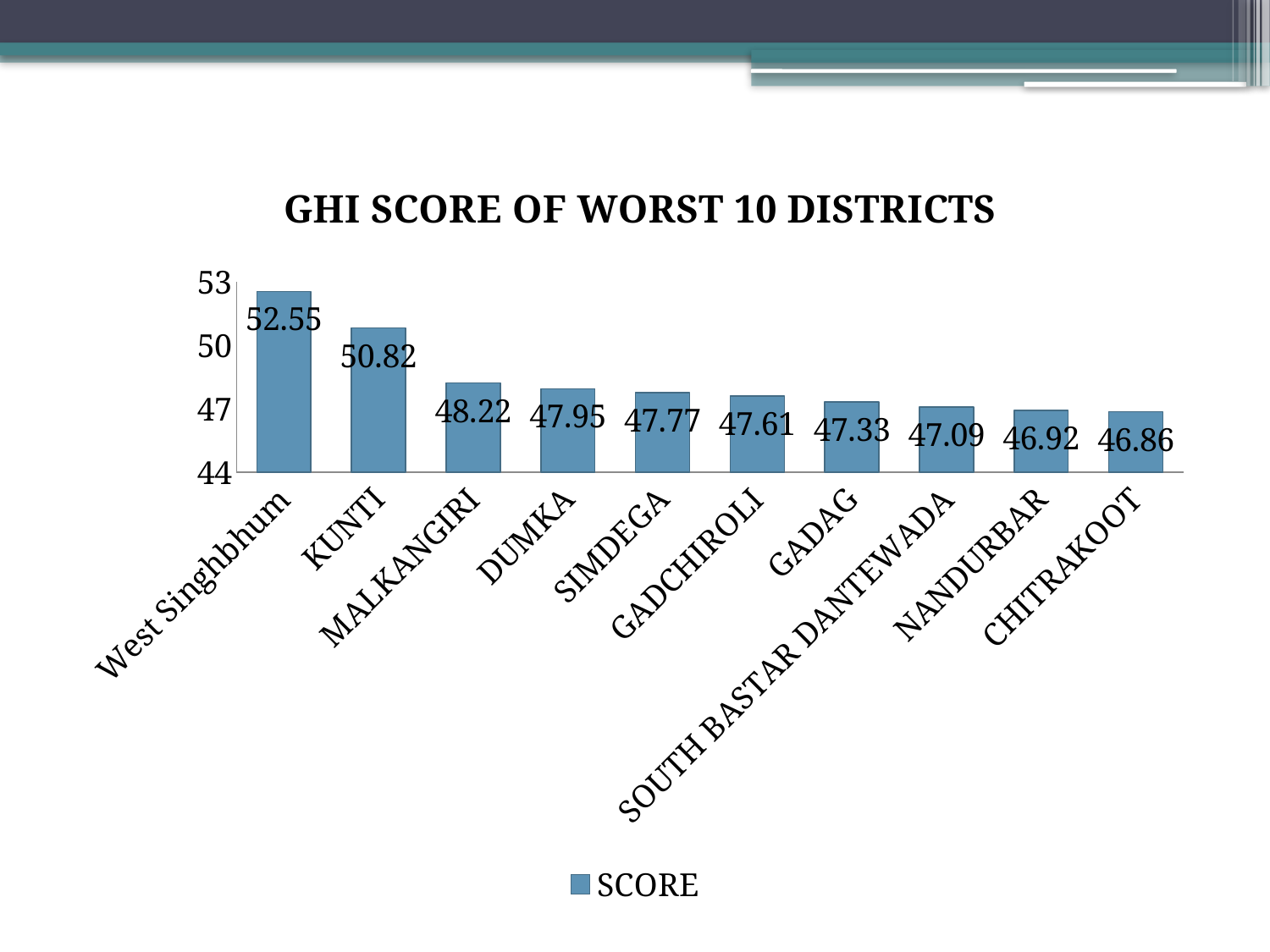
Which has a higher GHI score, MALKANGIRI or GADAG? MALKANGIRI Which district has the lowest GHI score? CHITRAKOOT What is the GHI score for CHITRAKOOT? 46.86 What kind of chart is shown on the slide? Bar chart Which district has the highest GHI score? West Singhbhum What is the GHI score for West Singhbhum? 52.55 What is the difference between the GHI scores of West Singhbhum and KUNTI? 1.73 How many districts are shown in the chart? 10 What is the GHI score for KUNTI? 50.82 What is the GHI score for SOUTH BASTAR DANTEWADA? 47.09 How many series does the legend list? 1 Do the GHI scores rise or fall from left to right along the x axis? Fall